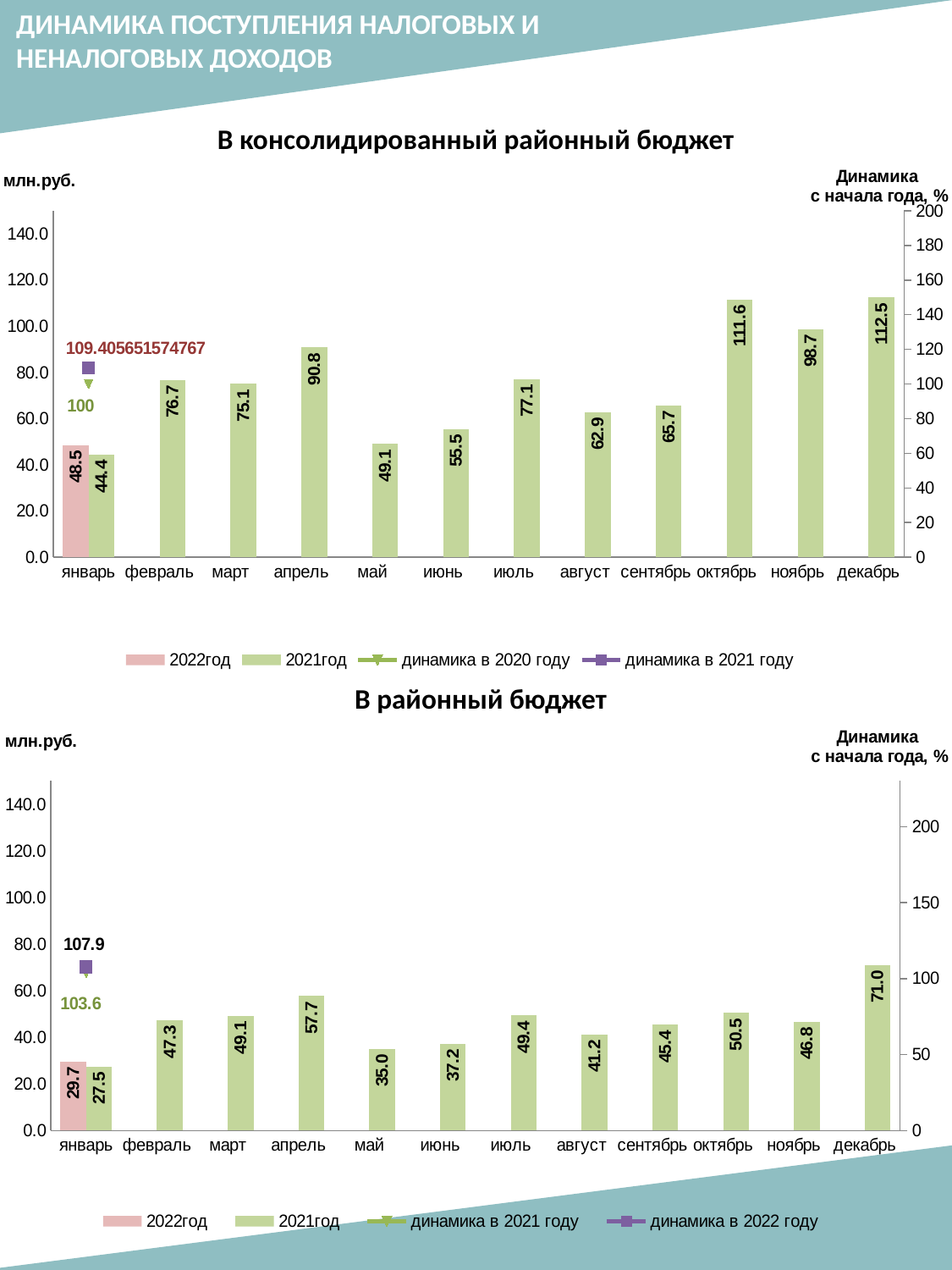
In the chart 'В консолидированный районный бюджет', what is the value of 'динамика в 2020 году' for январь? 100 In the chart 'В консолидированный районный бюджет', what is the difference between the 2022год and 2021год values for январь? 4.1 In the chart 'В районный бюджет', what is the value for 2021год in декабрь? 71.0 In the chart 'В консолидированный районный бюджет', how many series does the legend list? 4 In the chart 'В консолидированный районный бюджет', which month has the lowest 2021год value? январь In the chart 'В консолидированный районный бюджет', which month has the highest 2021год value? декабрь In the chart 'В районный бюджет', how many months are shown on the x axis? 12 In the chart 'В районный бюджет', which month has the lowest 2021год value? январь In the chart 'В районный бюджет', what is the difference between the 2022год and 2021год values for январь? 2.2 In the chart 'В районный бюджет', which is larger: the 2021год value for апрель or for июль? апрель In the chart 'В консолидированный районный бюджет', what is the value for 2021год in октябрь? 111.6 In the chart 'В районный бюджет', what is the value of 'динамика в 2022 году' for январь? 107.9